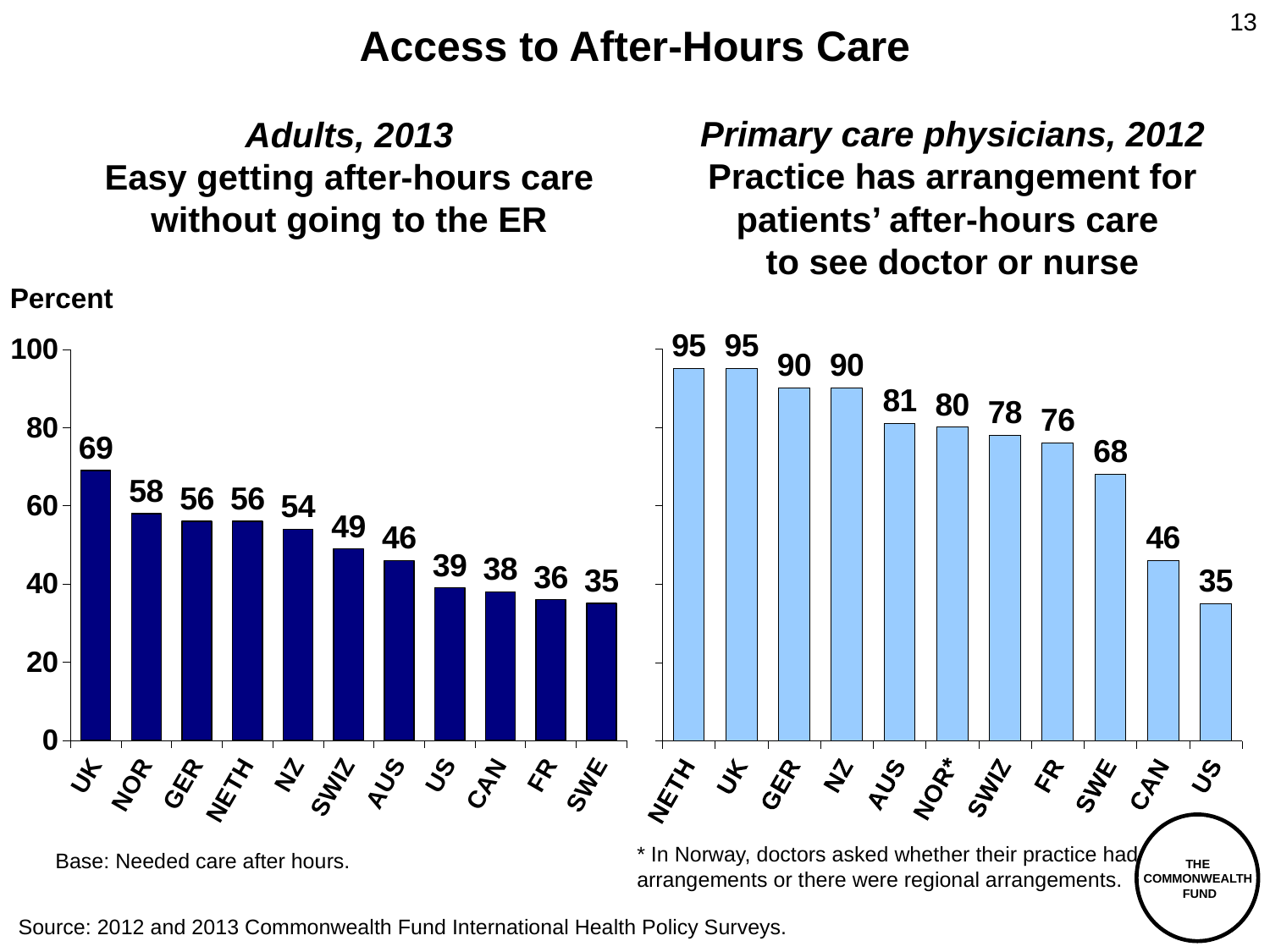
In the left chart (Adults, 2013), what is the value for the UK? 69 In the left chart (Adults, 2013), is the value for NZ greater or less than 60? less In the right chart (Primary care physicians, 2012), what is the value for SWE? 68 In the right chart (Primary care physicians, 2012), what is the difference between NETH and US? 60 In the right chart (Primary care physicians, 2012), which country has the lowest value? US In the left chart (Adults, 2013), which country has the lowest value? SWE What kind of chart is the left chart (Adults, 2013)? bar chart In the left chart (Adults, 2013), which country has the highest value? UK How many countries are shown in the right chart (Primary care physicians, 2012)? 11 In the right chart (Primary care physicians, 2012), do the values rise or fall from left to right? fall In the right chart (Primary care physicians, 2012), which is larger, the value for AUS or the value for FR? AUS In the left chart (Adults, 2013), what is the difference between the UK and the US? 30